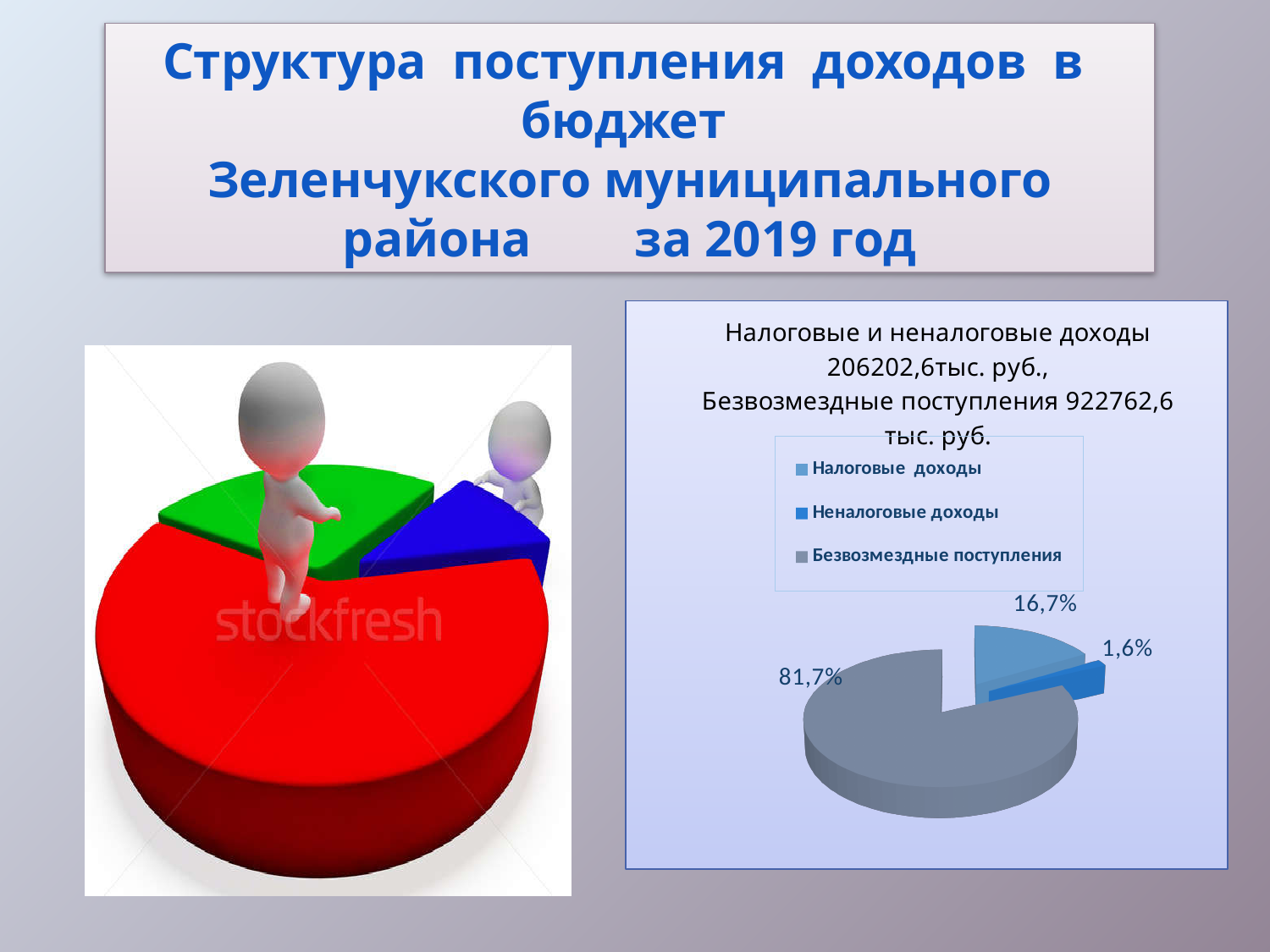
What share of the pie does Безвозмездные поступления have? 81,7% What share of the pie does Неналоговые доходы have? 1,6% How many slices does the pie chart have? 3 Which is larger, the share for Налоговые доходы or the share for Неналоговые доходы? Налоговые доходы What share of the pie does Налоговые доходы have? 16,7% Which category has the smallest slice of the pie? Неналоговые доходы Which legend entry is shown in grey? Безвозмездные поступления Which category has the largest slice of the pie? Безвозмездные поступления What kind of chart is shown on the slide? pie chart What is the difference in percentage points between Безвозмездные поступления and Налоговые доходы? 65 percentage points How many entries does the legend list? 3 What is the combined share of Налоговые доходы and Неналоговые доходы? 18,3%